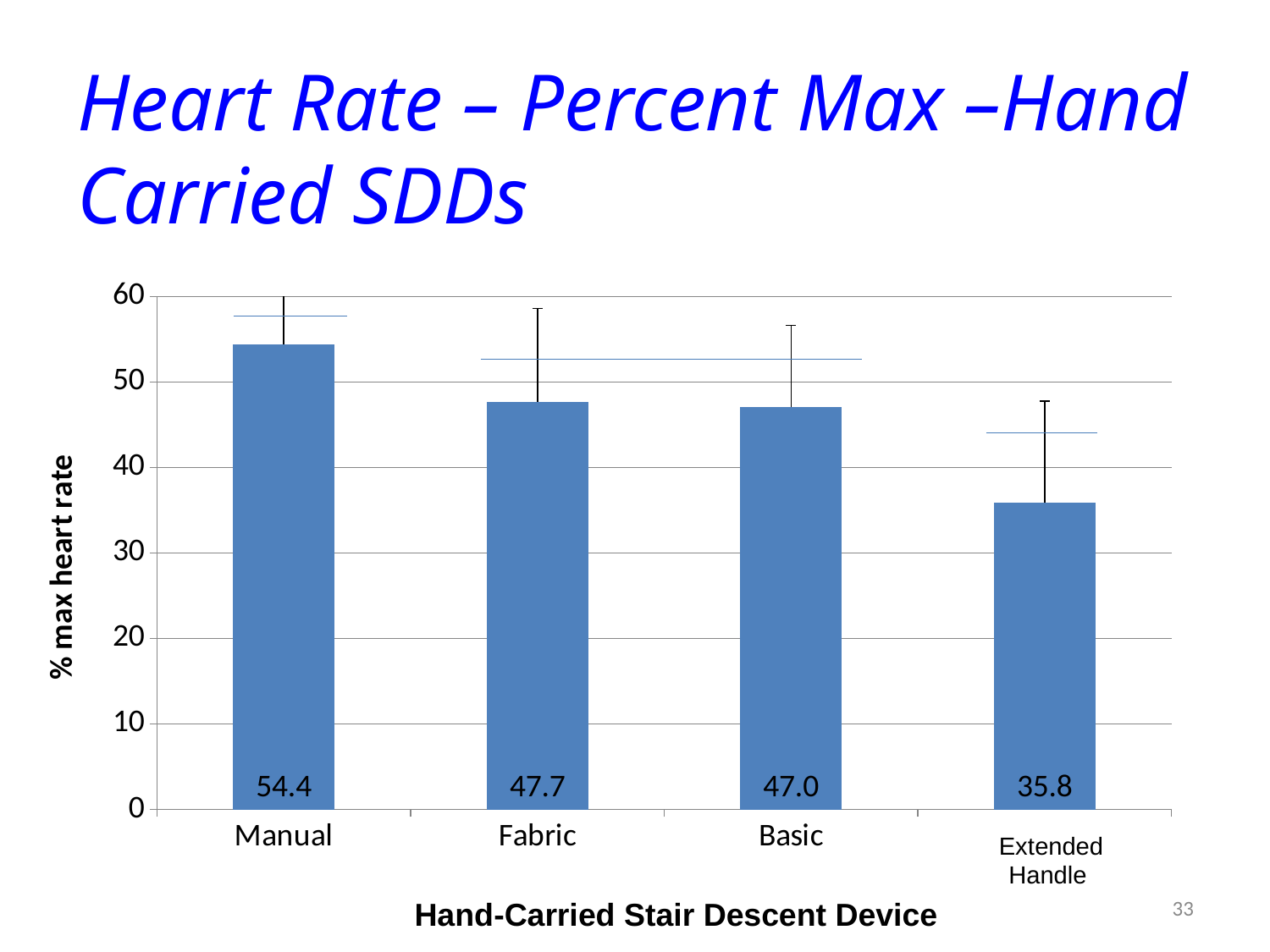
What is the % max heart rate for the Fabric device? 47.7 What is the difference in % max heart rate between the Fabric and Basic devices? 0.7 Which has a higher % max heart rate, Manual or Basic? Manual What is the difference in % max heart rate between the Manual and Extended Handle devices? 18.6 What kind of chart is shown on the slide? Bar chart Which device has the highest % max heart rate? Manual What is the % max heart rate for the Manual device? 54.4 What is the % max heart rate for the Extended Handle device? 35.8 What is the label of the x axis? Hand-Carried Stair Descent Device How many devices are shown on the x axis? 4 Is the value for Extended Handle greater or less than 40? less Which device has the lowest % max heart rate? Extended Handle